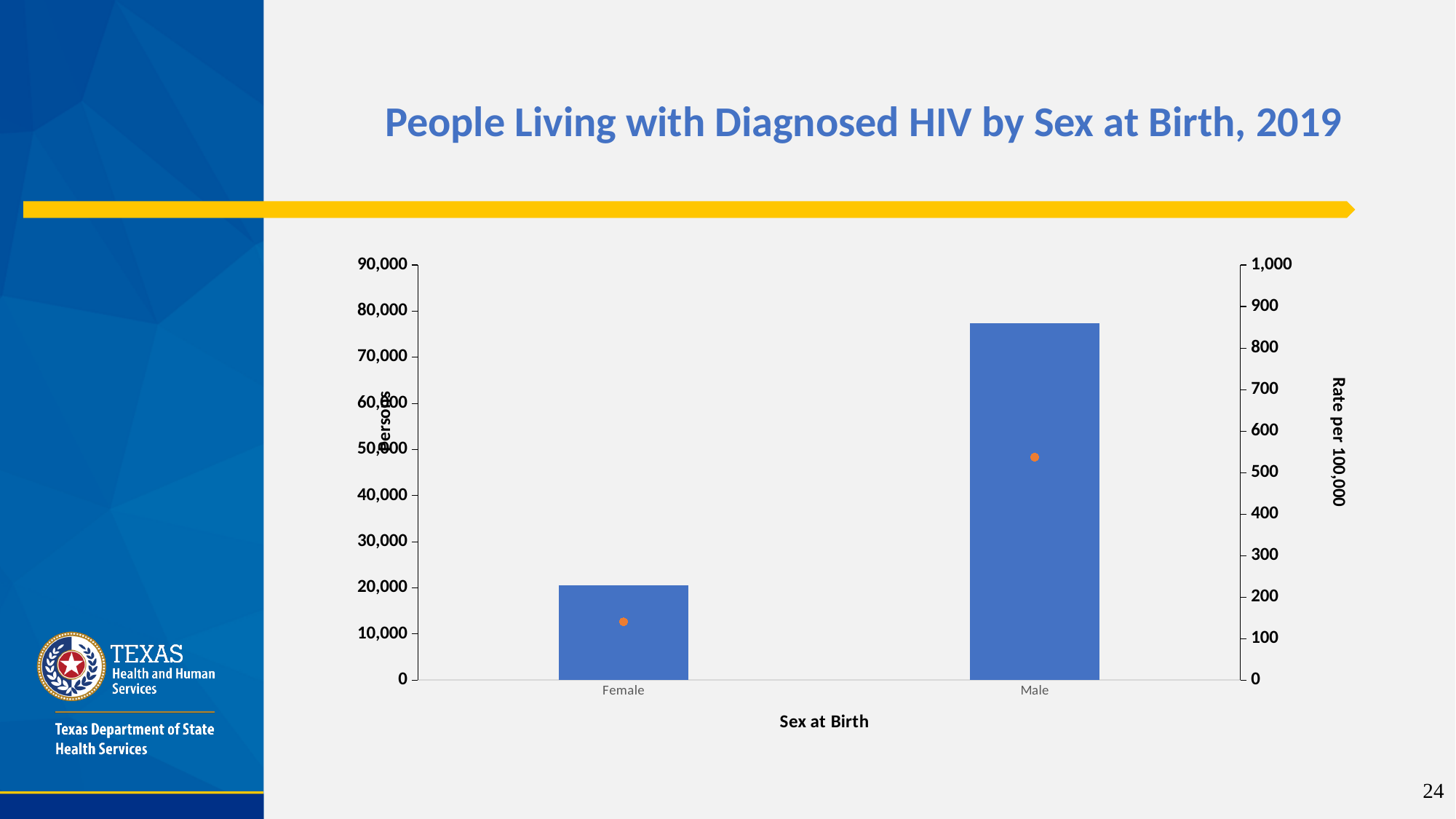
Is the number of persons for Male greater or less than 70,000? greater What is the title of the chart? People Living with Diagnosed HIV by Sex at Birth, 2019 What is the label of the right-hand vertical axis? Rate per 100,000 Which sex at birth has the lowest number of persons living with diagnosed HIV? Female Is the rate per 100,000 for Male greater or less than 400? greater Which sex at birth has the highest number of persons living with diagnosed HIV? Male Is the rate per 100,000 for Female greater or less than 200? less How many categories are shown on the x axis of the chart? 2 What kind of chart is shown on the slide? bar chart Which is larger, the number of persons for Female or for Male? Male Do the bar values rise or fall from Female to Male along the x axis? rise